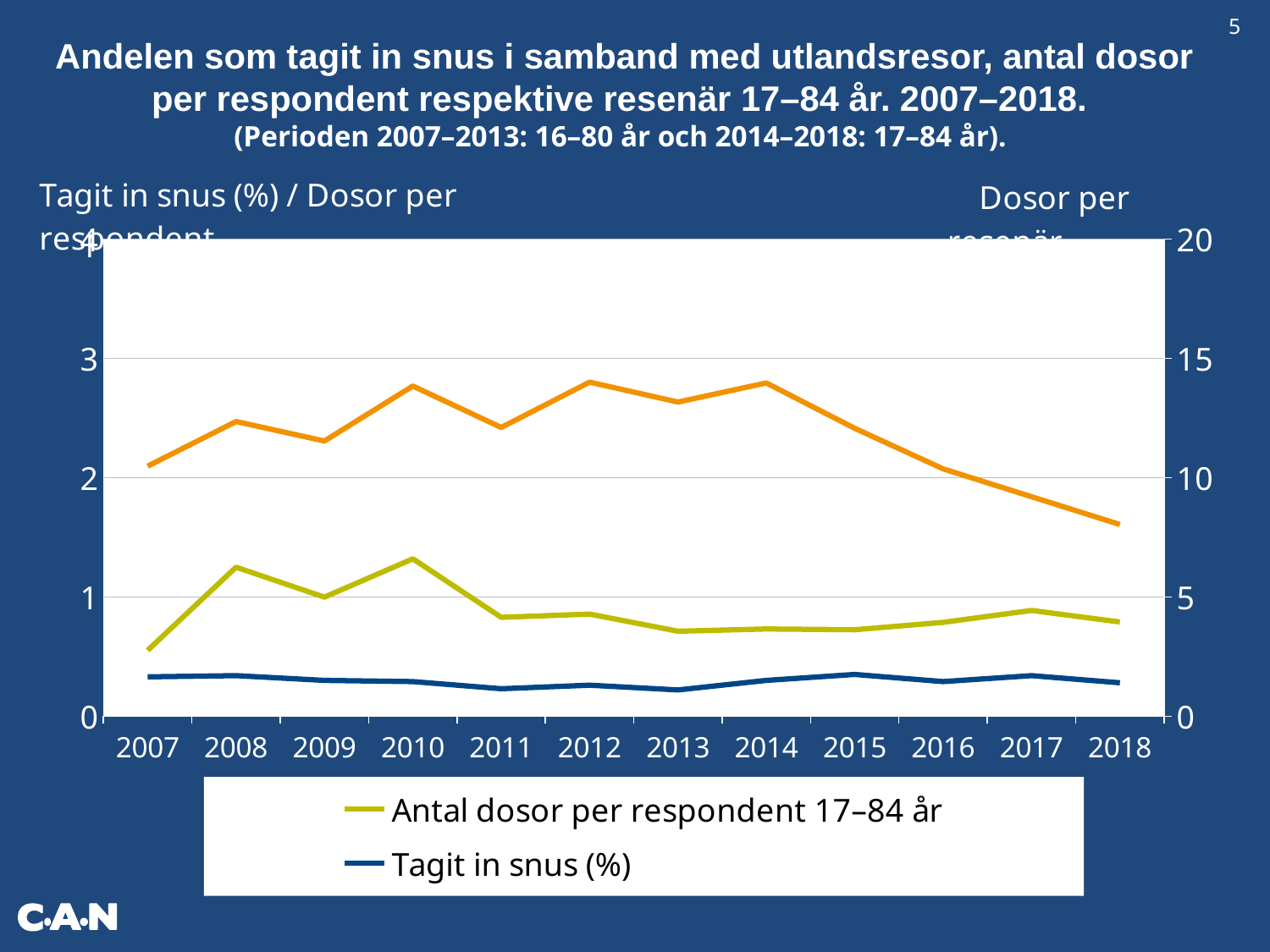
Which is larger: 'Antal dosor per respondent 17–84 år' in 2008 or in 2013? 2008 Is the value for 'Antal dosor per respondent 17–84 år' in 2011 greater or less than 1 on the left axis? less Which series has the higher value in 2010: 'Antal dosor per respondent 17–84 år' or 'Tagit in snus (%)'? Antal dosor per respondent 17–84 år What is the highest tick value shown on the right-hand axis? 20 How many series does the chart's legend list? 2 Does the orange line rise or fall between 2014 and 2018? fall In which year does the orange line reach its lowest value? 2018 How many years are shown along the x axis of the chart? 12 Is the value for 'Antal dosor per respondent 17–84 år' in 2010 greater or less than 1 on the left axis? greater What kind of chart is shown on the slide? line chart Is the value for 'Tagit in snus (%)' in 2015 greater or less than 1 on the left axis? less Which year has the lowest value for 'Antal dosor per respondent 17–84 år'? 2007